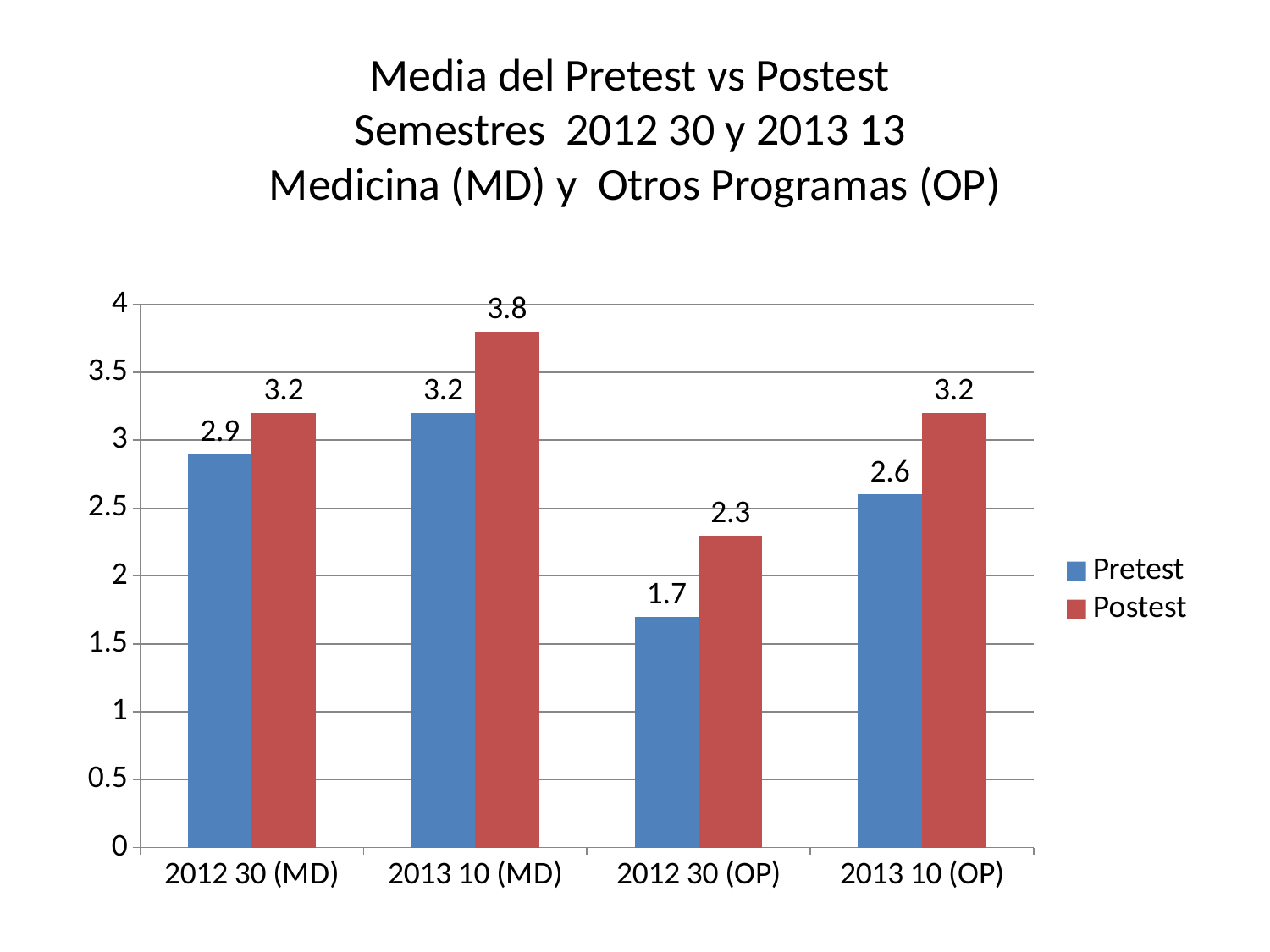
What is the Pretest value for 2012 30 (MD)? 2.9 Which is larger for 2013 10 (OP): the Pretest value or the Postest value? Postest What is the Pretest value for 2012 30 (OP)? 1.7 Which category has the highest Postest value? 2013 10 (MD) Which colour represents the Postest series? Red What is the Postest value for 2013 10 (OP)? 3.2 What is the difference between the Postest and Pretest values for 2012 30 (OP)? 0.6 What kind of chart is shown on the slide? Bar chart How many categories are shown on the x axis? 4 How many series does the legend list? 2 What is the Postest value for 2013 10 (MD)? 3.8 Which category has the lowest Pretest value? 2012 30 (OP)